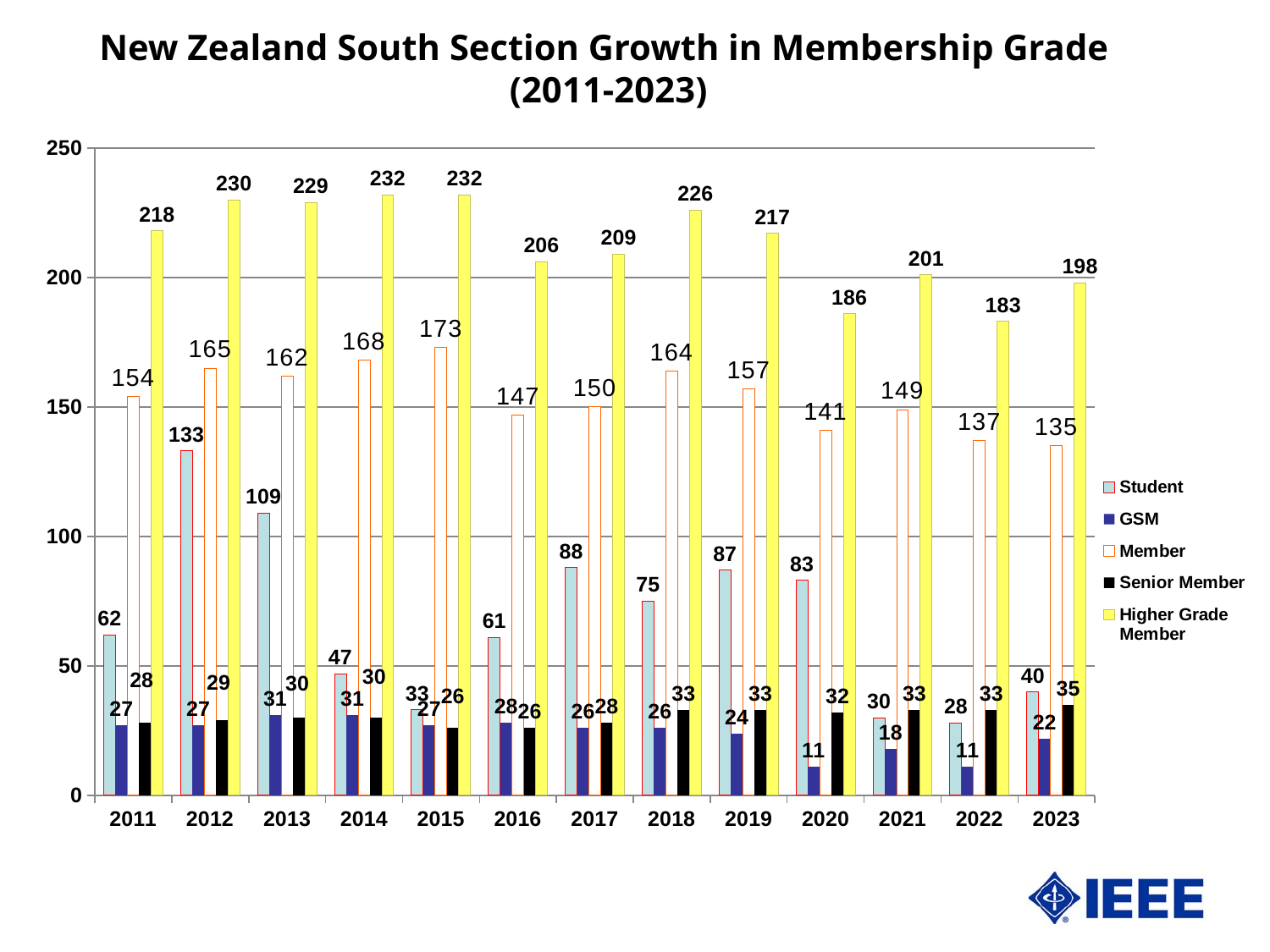
What is the title of the chart? New Zealand South Section Growth in Membership Grade (2011-2023) What is the GSM value for 2020? 11 What is the Member value for 2015? 173 What is the Higher Grade Member value for 2023? 198 How many years are shown on the x axis? 13 What is the Student value for 2012? 133 What kind of chart is shown on the slide? Bar chart How many series does the legend list? 5 What is the difference between the Higher Grade Member values for 2012 and 2022? 47 In which year is the Member value lowest? 2023 In which year is the Student value highest? 2012 Which is larger, the Student value for 2017 or the Student value for 2019? 2017